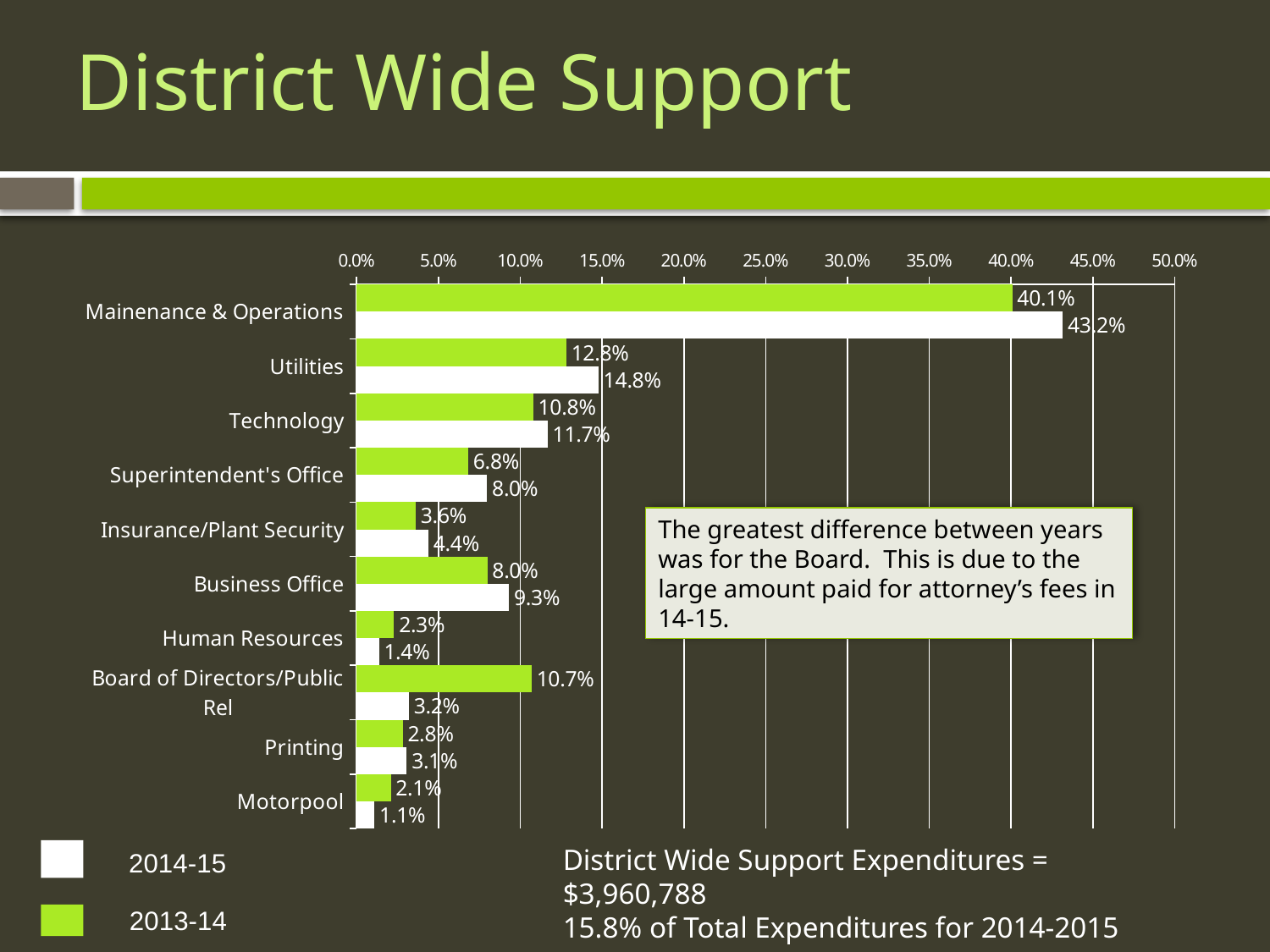
How many categories are shown on the chart? 10 Which colour represents the 2013-14 series in the legend? green Is the 2014-15 value for Mainenance & Operations greater or less than 40.0%? greater Which category has the lowest 2014-15 value? Motorpool What is the difference between the 2014-15 and 2013-14 values for Board of Directors/Public Rel? 7.5% Which category has the highest 2014-15 value? Mainenance & Operations What kind of chart is shown on the slide? bar chart What is the 2014-15 value for Utilities? 14.8% Which is larger for Human Resources, the 2014-15 value or the 2013-14 value? 2013-14 What is the 2014-15 value for Technology? 11.7% What is the 2013-14 value for Board of Directors/Public Rel? 10.7% How many series does the legend list? 2